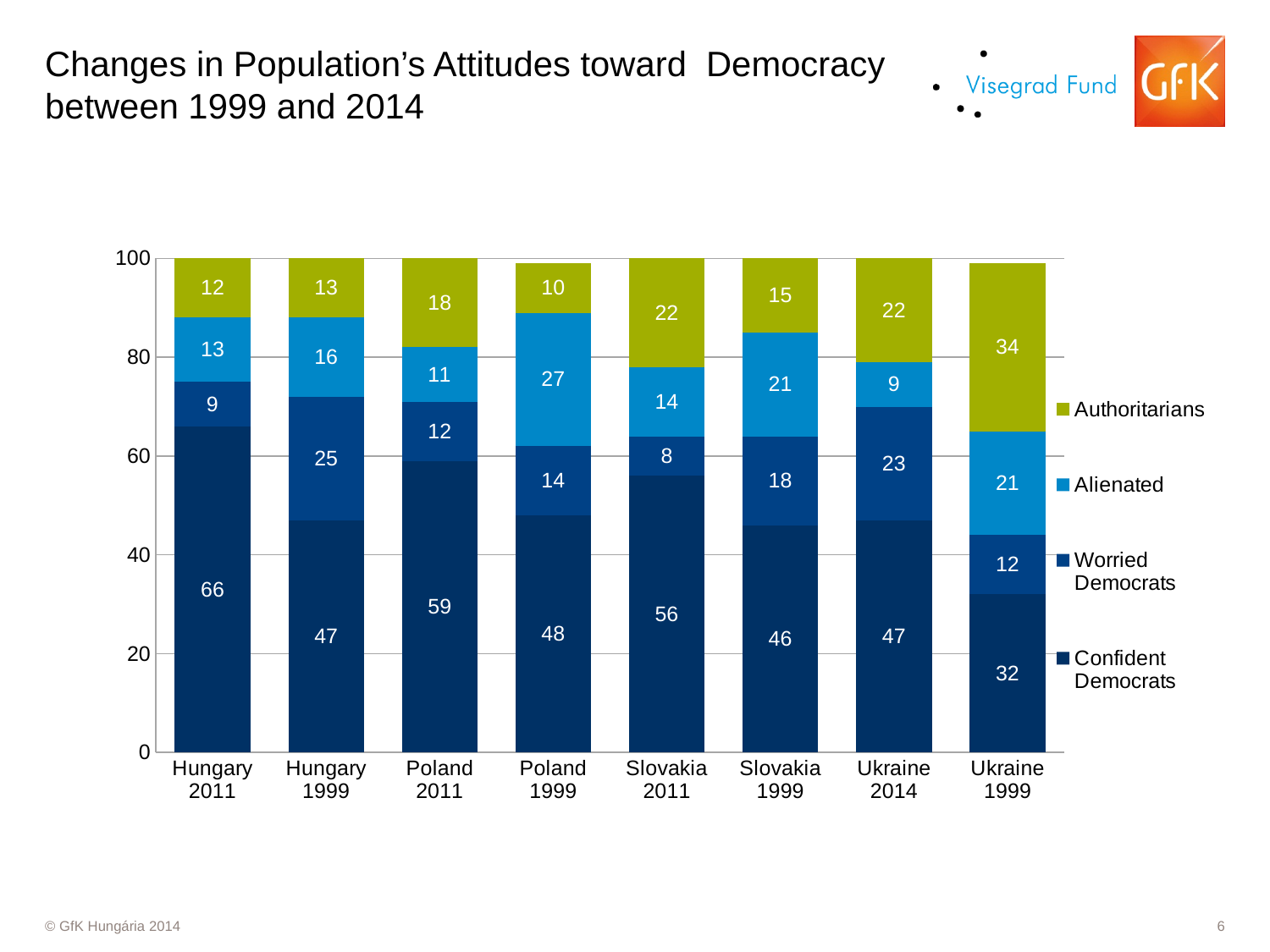
Which category has the highest value for Confident Democrats? Hungary 2011 How many categories are shown on the x axis? 8 What kind of chart is shown on the slide? Stacked bar chart What is the value for Worried Democrats in Ukraine 2014? 23 What is the value for Alienated in Poland 1999? 27 What is the value for Authoritarians in Ukraine 1999? 34 What is the difference between the Confident Democrats values for Hungary 2011 and Hungary 1999? 19 Which category has the lowest value for Confident Democrats? Ukraine 1999 How many series does the legend list? 4 Which is larger, the Authoritarians value for Slovakia 2011 or for Slovakia 1999? Slovakia 2011 What is the value for Confident Democrats in Hungary 2011? 66 What is the total of the stacked bar for Poland 2011? 100